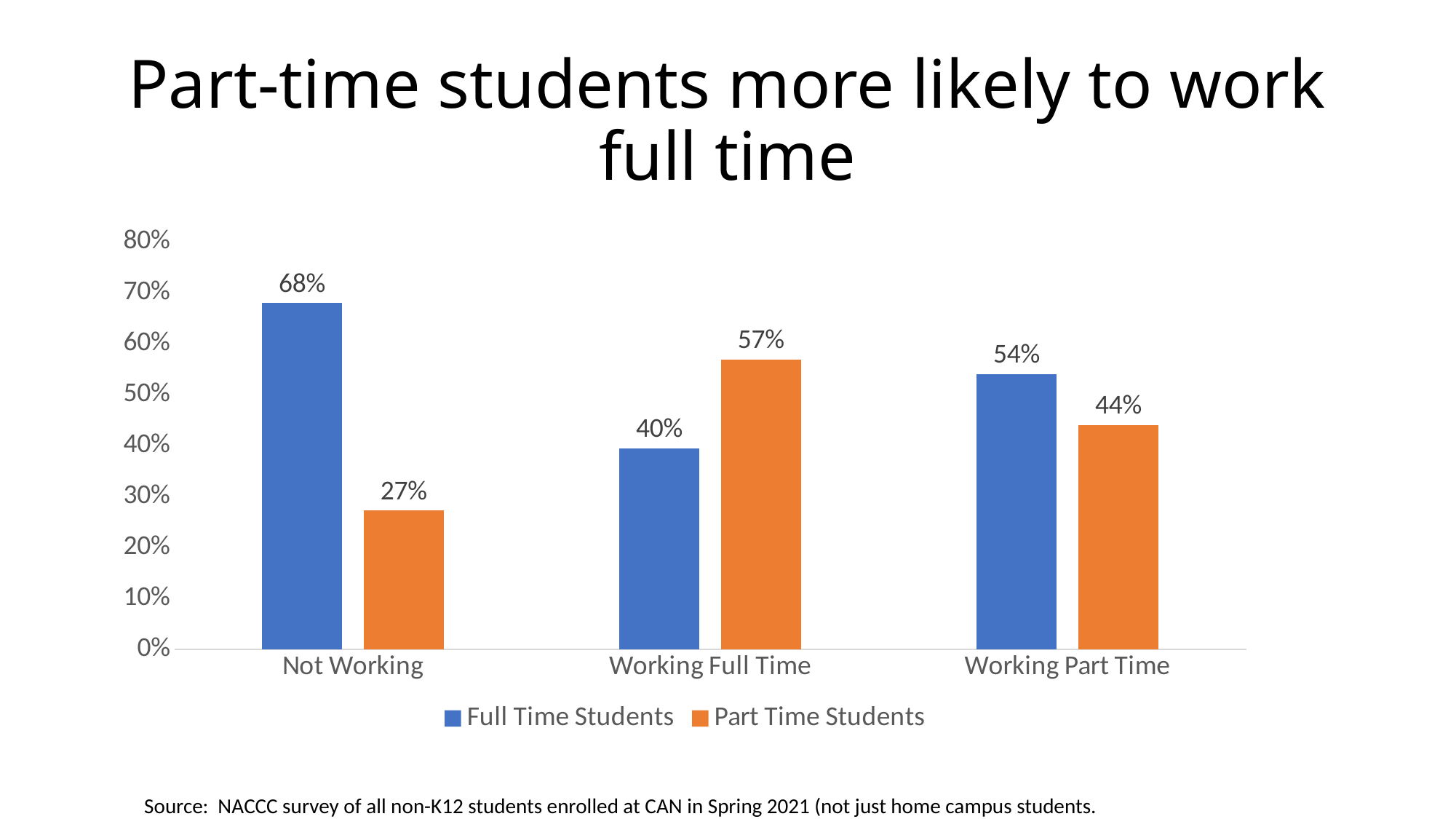
Which category has the lowest value for Part Time Students? Not Working What kind of chart is shown on the slide? Bar chart Which category has the highest value for Full Time Students? Not Working How many series does the legend list? 2 What percentage of Part Time Students are Working Full Time? 57% What percentage of Full Time Students are Not Working? 68% What is the difference between Full Time Students and Part Time Students in the Not Working category? 41% What colour represents Part Time Students in the chart? Orange In the Working Part Time category, which series has the larger value? Full Time Students How many categories are shown on the x axis? 3 What is the value for Part Time Students in the Working Part Time category? 44% What is the difference between Part Time Students and Full Time Students in the Working Full Time category? 17%